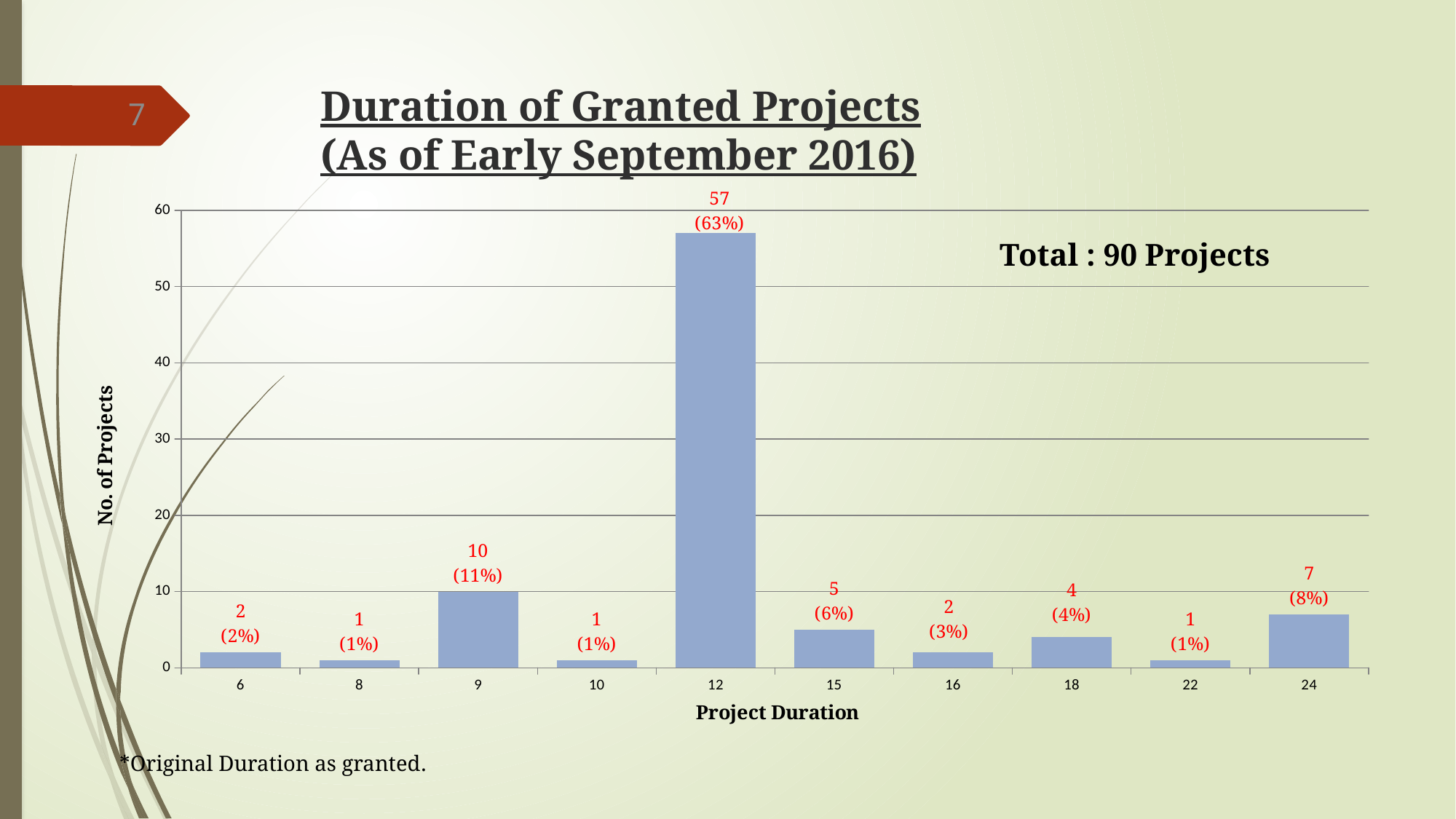
Which project duration has the highest number of projects? 12 How many projects have a project duration of 16? 2 How many projects have a project duration of 24? 7 How many projects have a project duration of 12? 57 What kind of chart is shown on the slide? bar chart What is the label of the y axis? No. of Projects What percentage of projects have a project duration of 9? 11% How many project duration categories are shown on the x axis? 10 Which has more projects: duration 15 or duration 18? 15 Is the number of projects for duration 12 greater or less than 50? greater What is the total number of projects stated on the slide? 90 Projects What is the difference in the number of projects between duration 12 and duration 9? 47